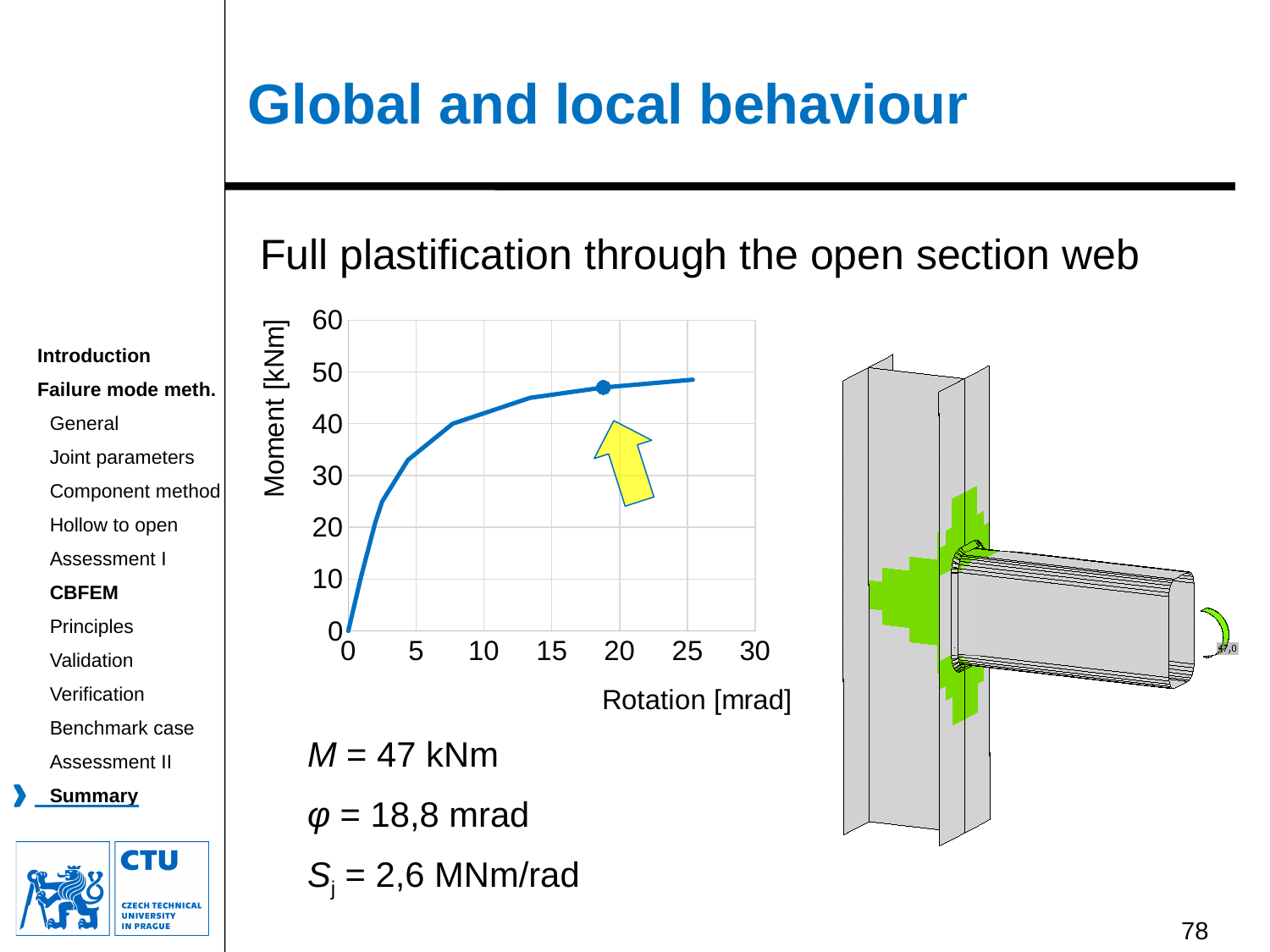
What is the highest value shown on the vertical axis of the chart? 60 Does the moment rise or fall as the rotation increases along the x axis? rise Is the moment at a rotation of 5 mrad greater or less than 30 kNm? greater What type of chart is shown on the slide? line chart How many data series are plotted on the chart? 1 Is the moment at a rotation of 1 mrad greater or less than 20 kNm? less Is the moment at a rotation of 25 mrad greater or less than 50 kNm? less What is the moment value at the highlighted point on the curve? 47 kNm What is the label of the vertical axis of the chart? Moment [kNm] What is the label of the horizontal axis of the chart? Rotation [mrad] What is the rotation value at the highlighted point on the curve? 18,8 mrad